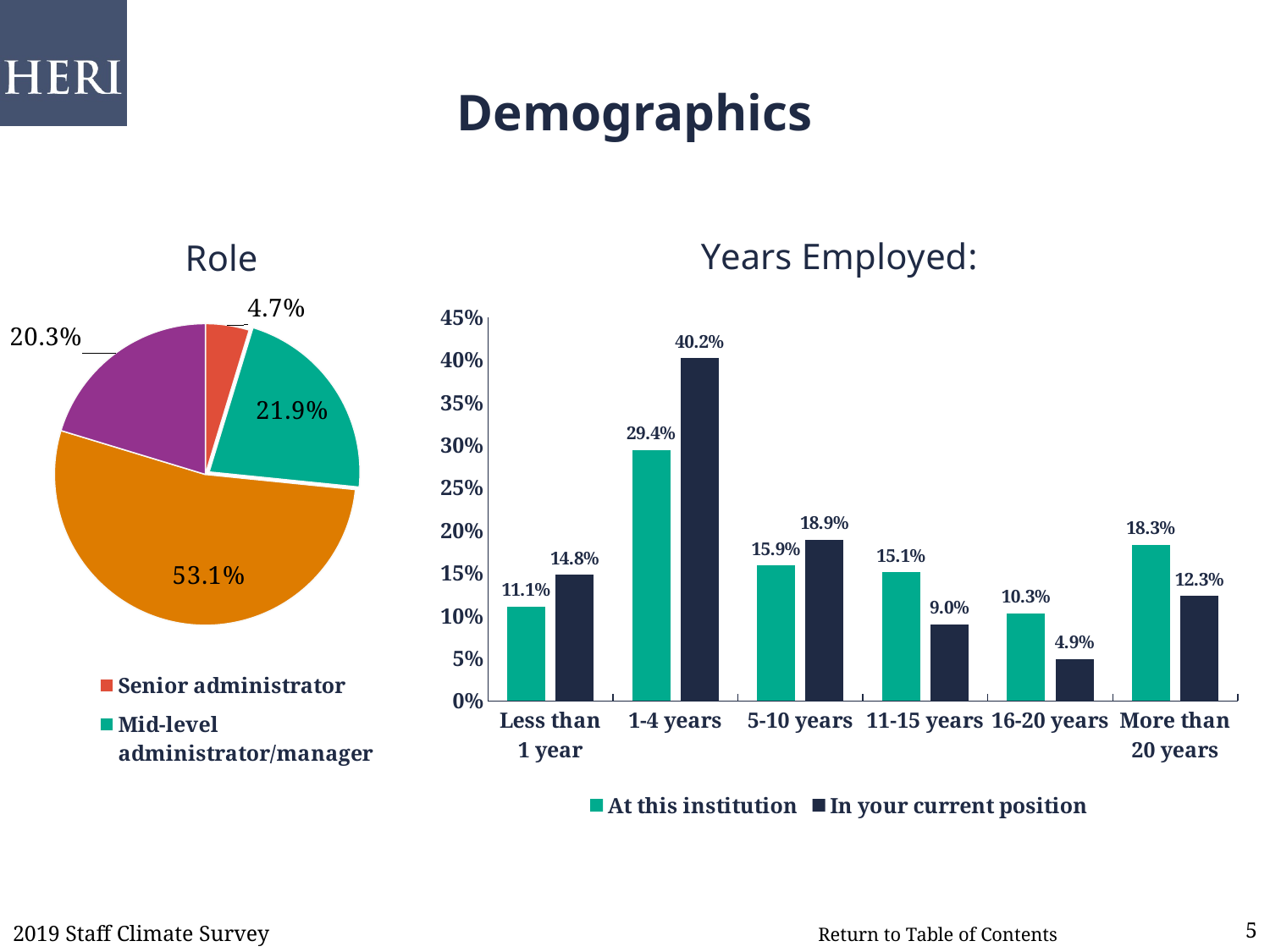
In the Role chart, how many slices does the pie have? 4 In the Years Employed chart, which category has the lowest value for In your current position? 16-20 years In the Years Employed chart, how many series does the legend list? 2 What kind of chart is the Role chart? Pie chart In the Years Employed chart, what is the difference between In your current position and At this institution for 1-4 years? 10.8 percentage points In the Years Employed chart, what is the value for 16-20 years in the At this institution series? 10.3% In the Years Employed chart, what is the value for 1-4 years in the In your current position series? 40.2% In the Years Employed chart, for 11-15 years, which series has the larger value: At this institution or In your current position? At this institution In the Years Employed chart, how many categories are shown on the x axis? 6 In the Years Employed chart, which category has the highest value for In your current position? 1-4 years In the Role chart, what share of the pie is Senior administrator? 4.7% In the Role chart, what is the share of the largest slice? 53.1%